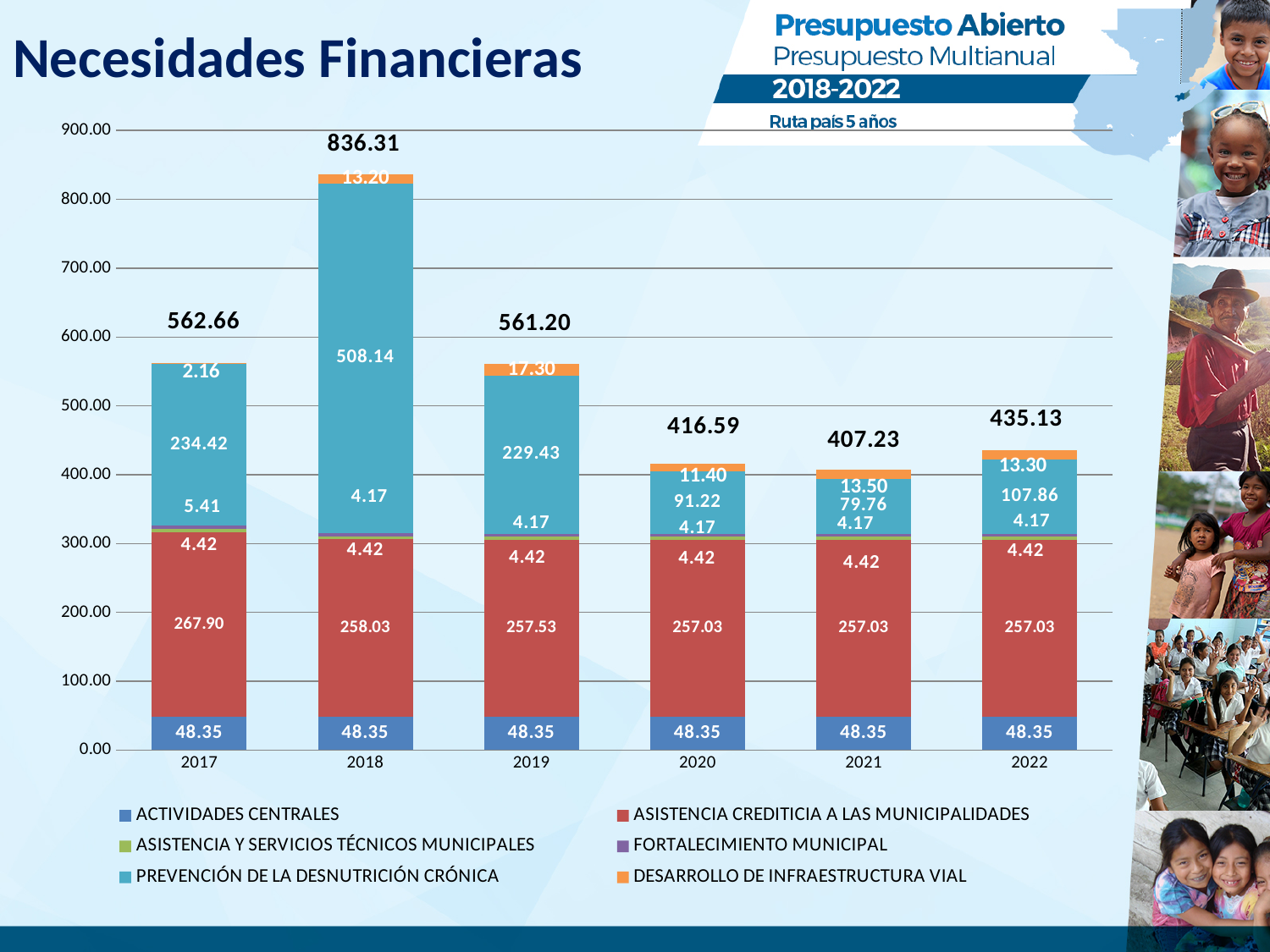
Which year has the larger total, 2021 or 2022? 2022 Which year has the lowest total in the chart? 2021 What is the total value of the bar for 2020? 416.59 What is the difference between the total for 2018 and the total for 2017? 273.65 Which year has the highest total in the chart? 2018 What is the value of ASISTENCIA CREDITICIA A LAS MUNICIPALIDADES in 2017? 267.90 What is the value of PREVENCIÓN DE LA DESNUTRICIÓN CRÓNICA in 2018? 508.14 What is the title of the chart on the slide? Necesidades Financieras What is the value of DESARROLLO DE INFRAESTRUCTURA VIAL in 2019? 17.30 What kind of chart is shown on the slide? Stacked bar chart How many years are shown on the x axis of the chart? 6 How many series does the chart's legend list? 6